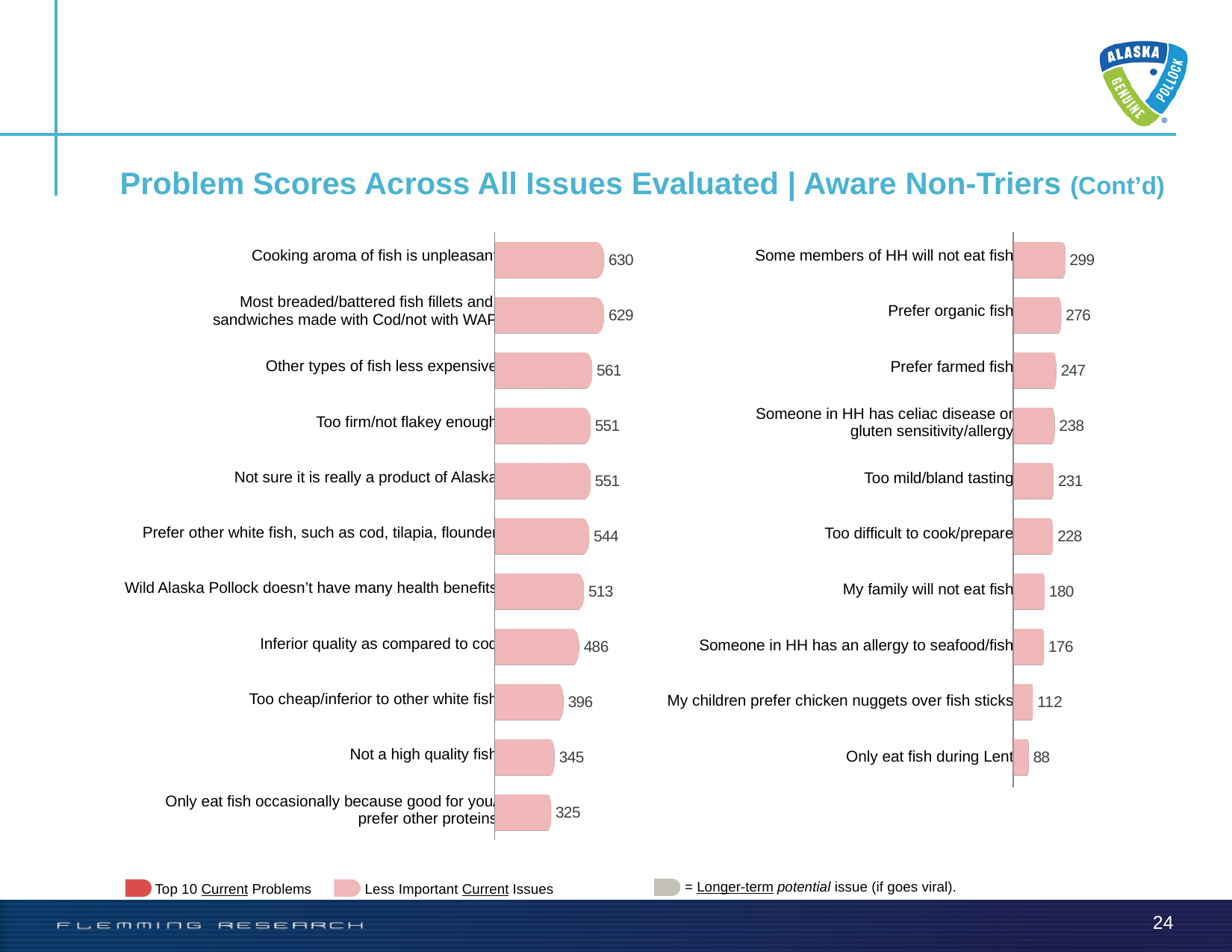
How many issues are plotted on the right chart? 10 On the left chart, which has a higher score: 'Not a high quality fish' or 'Too cheap/inferior to other white fish'? Too cheap/inferior to other white fish How many issues are plotted on the left chart? 11 On the left chart, what is the problem score for 'Too cheap/inferior to other white fish'? 396 On the left chart, what is the difference between the scores for 'Other types of fish less expensive' and 'Inferior quality as compared to cod'? 75 On the left chart, what is the problem score for 'Cooking aroma of fish is unpleasant'? 630 On the right chart, which issue has the lowest problem score? Only eat fish during Lent On the right chart, what is the problem score for 'Prefer organic fish'? 276 What type of chart is used on this slide? Bar chart On the left chart, which issue has the lowest problem score? Only eat fish occasionally because good for you, prefer other proteins On the right chart, what is the difference between the scores for 'My family will not eat fish' and 'My children prefer chicken nuggets over fish sticks'? 68 On the right chart, which issue has the highest problem score? Some members of HH will not eat fish